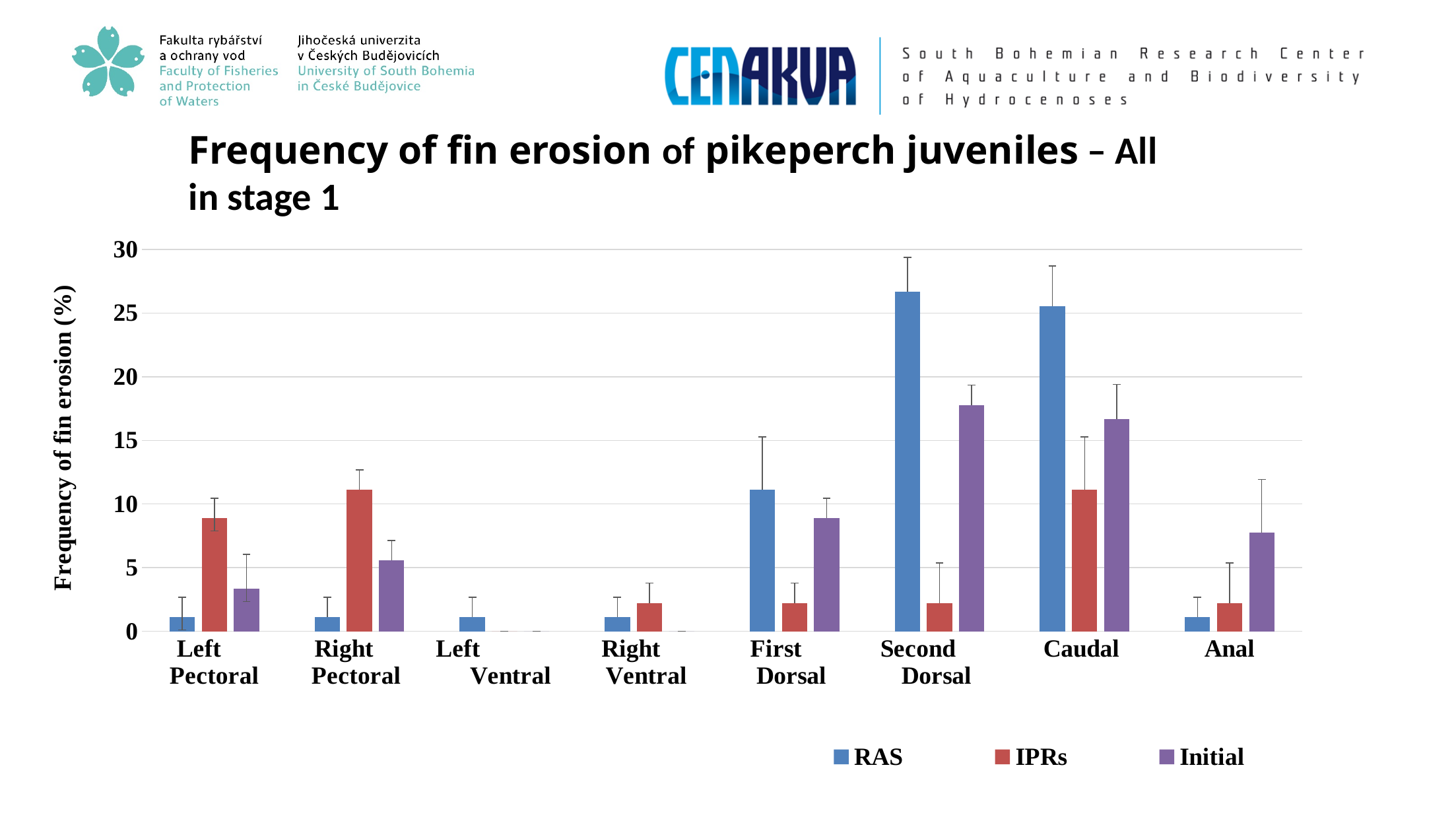
Is the RAS value for Second Dorsal greater or less than 25? greater Is the Initial value for Anal greater or less than 10? less How many series does the legend list? 3 For Left Pectoral, which is larger, the RAS value or the IPRs value? IPRs For Second Dorsal, which is larger, the RAS value or the IPRs value? RAS Is the Initial value for Second Dorsal greater or less than 15? greater How many fin categories are shown on the x axis? 8 What kind of chart is shown on the slide? bar chart What is the title of the y axis? Frequency of fin erosion (%)